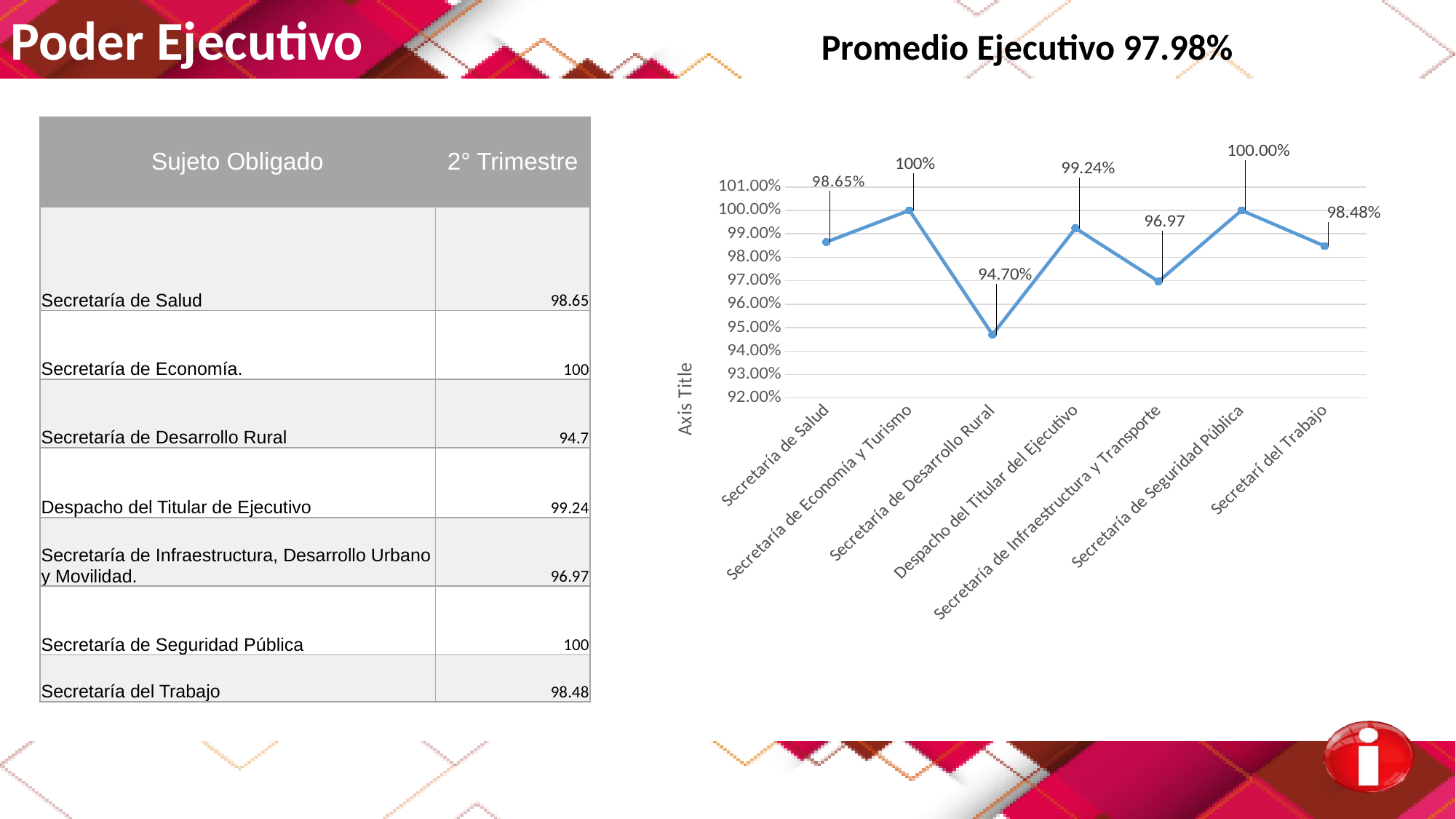
Is the value for Secretaría de Desarrollo Rural greater or less than 96.00%? less How many categories are plotted along the x axis of the chart? 7 What kind of chart is shown on the slide? line chart What value does the chart show for Secretaría de Infraestructura y Transporte? 96.97 What is the title shown on the vertical axis of the chart? Axis Title Does the line rise or fall from Secretaría de Economía y Turismo to Secretaría de Desarrollo Rural? fall What value does the chart show for Secretaría de Desarrollo Rural? 94.70% Which is larger, the value for Secretaría de Salud or the value for Secretarí del Trabajo? Secretaría de Salud Which category has the lowest value in the chart? Secretaría de Desarrollo Rural What value does the chart show for Despacho del Titular del Ejecutivo? 99.24% What is the difference between the values for Despacho del Titular del Ejecutivo and Secretaría de Desarrollo Rural? 4.54% What value does the chart show for Secretaría de Salud? 98.65%